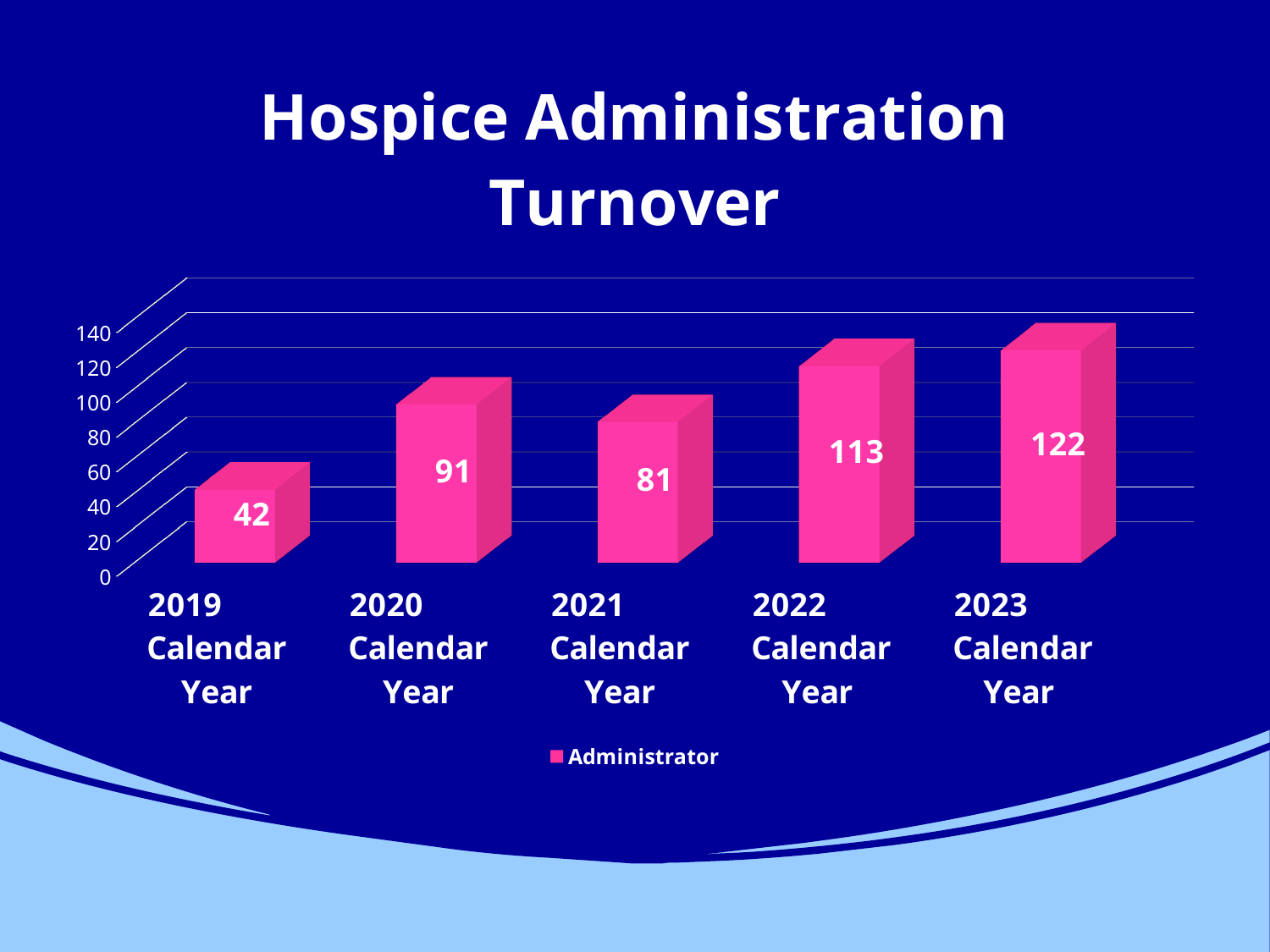
What is the difference between the Administrator turnover in the 2020 Calendar Year and the 2021 Calendar Year? 10 What is the Administrator turnover value for the 2021 Calendar Year? 81 What is the title of the chart? Hospice Administration Turnover Which is larger, the Administrator turnover in the 2020 Calendar Year or the 2021 Calendar Year? 2020 Calendar Year Which calendar year has the highest Administrator turnover? 2023 Calendar Year How many series does the legend list? 1 What is the Administrator turnover value for the 2022 Calendar Year? 113 Which calendar year has the lowest Administrator turnover? 2019 Calendar Year How many calendar years are shown on the chart? 5 What is the Administrator turnover value for the 2019 Calendar Year? 42 What is the difference between the Administrator turnover in the 2023 Calendar Year and the 2019 Calendar Year? 80 What kind of chart is shown on the slide? Bar chart